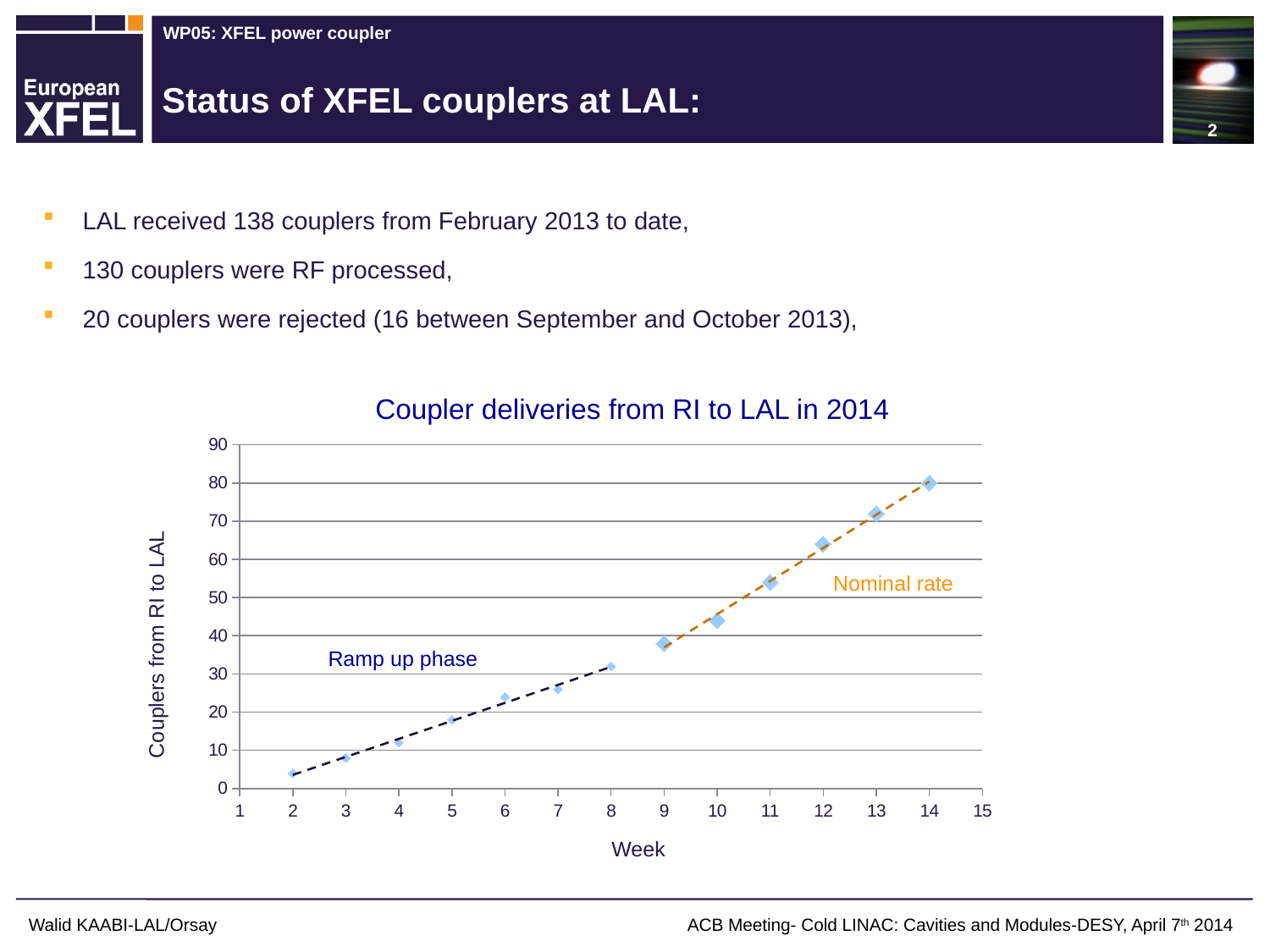
Which is larger, the value for week 9 or the value for week 12? week 12 Is the value for week 5 greater or less than 20? less Do the values rise or fall as the week number increases? rise Is the value for week 8 greater or less than 40? less What is the label of the x axis of the chart? Week Is the value for week 11 greater or less than 50? greater What is the value for week 14? 80 Which week has the lowest number of couplers from RI to LAL? 2 Which week has the highest number of couplers from RI to LAL? 14 What is the title of the chart? Coupler deliveries from RI to LAL in 2014 How many data points are plotted in the chart? 13 What kind of chart is shown on the slide? scatter chart